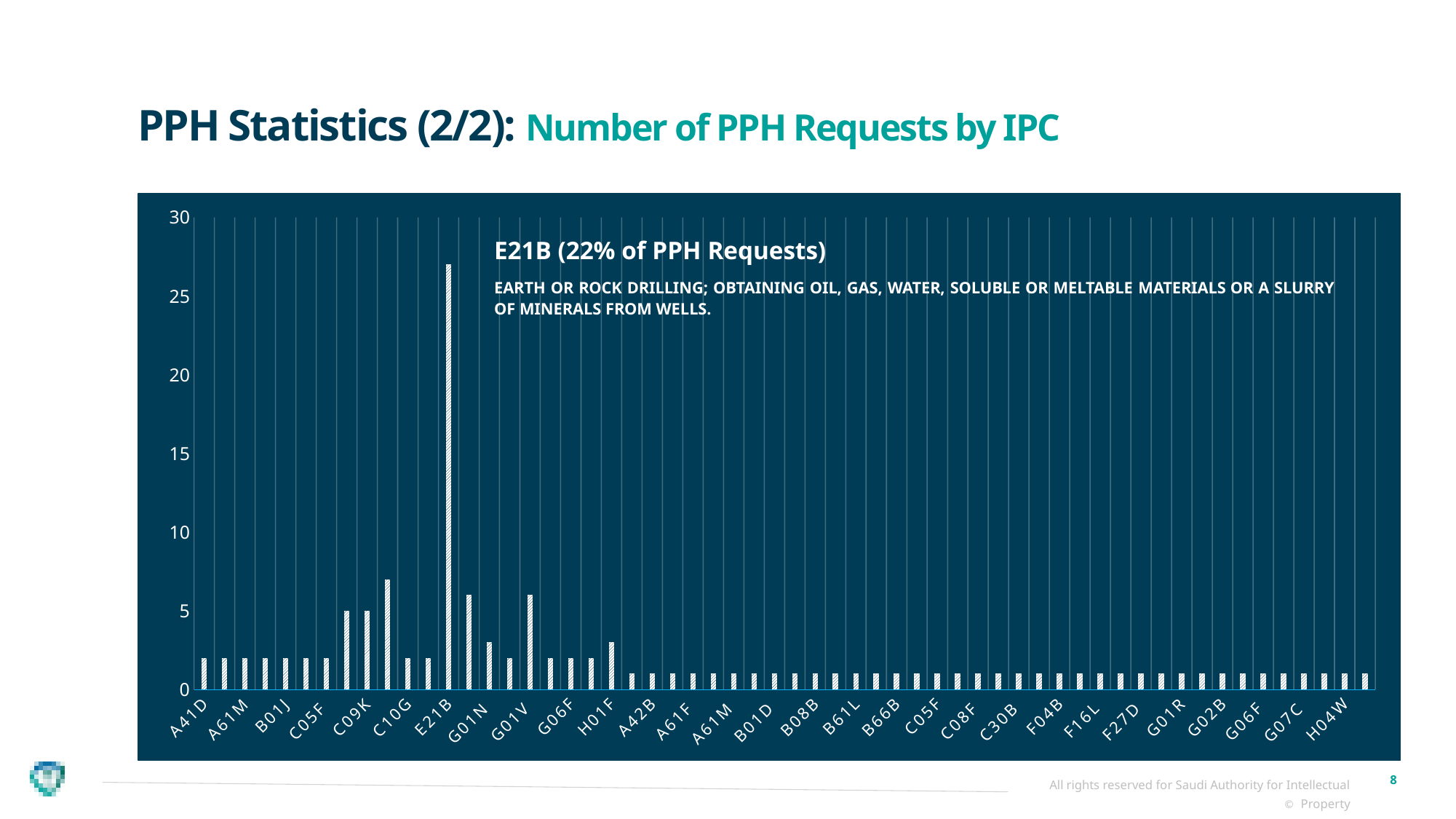
According to the annotation on the chart, what share of PPH requests does E21B account for? 22% Which has more PPH requests, H04W or E21B? E21B What kind of chart is shown on the slide? bar chart Is the value for G07C greater or less than 10? less Is the value for A41D greater or less than 5? less What is the title of the chart on the slide? Number of PPH Requests by IPC Is the value for E21B greater or less than 30? less Which IPC code has the highest number of PPH requests? E21B Which has more PPH requests, E21B or A41D? E21B